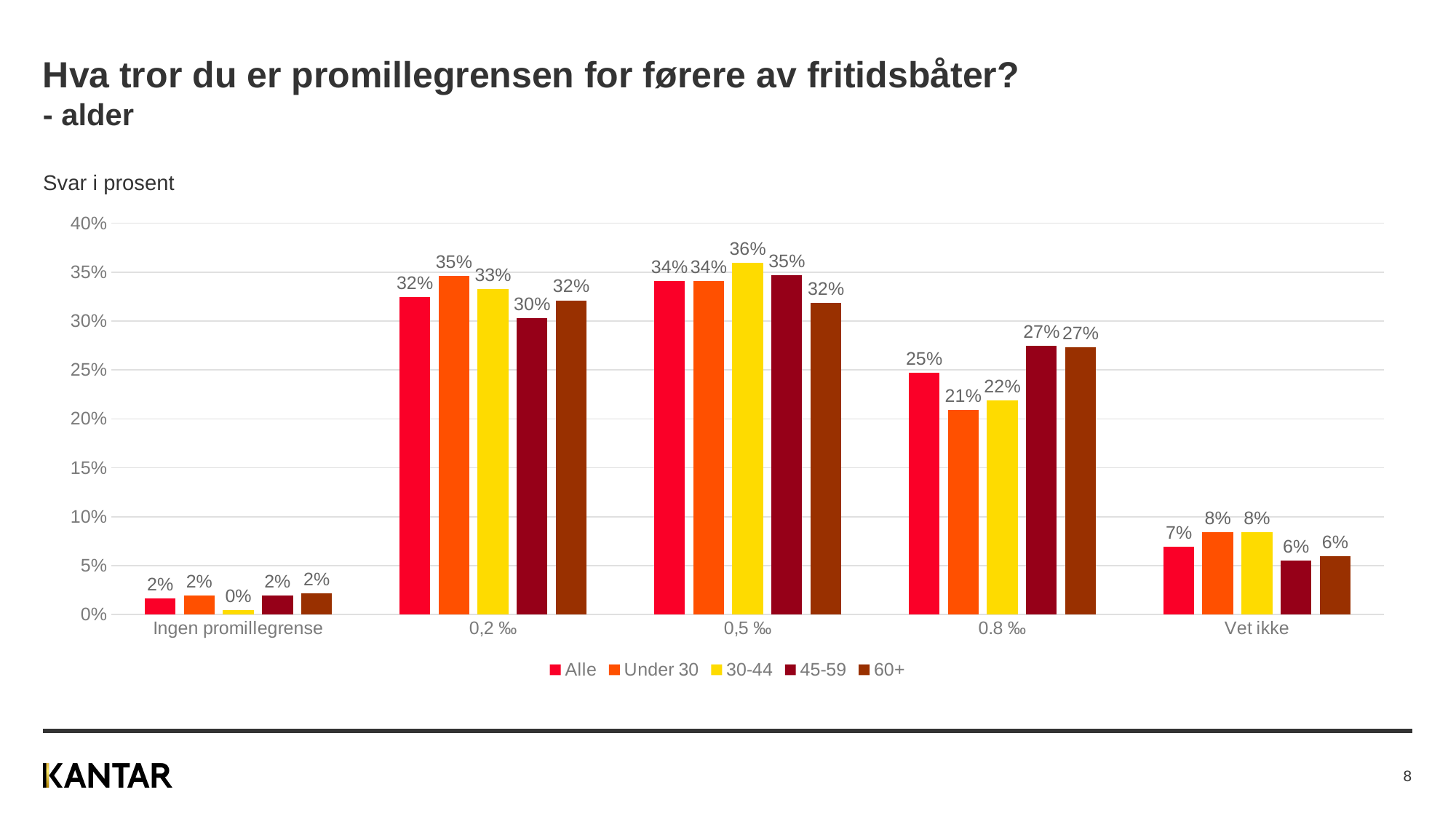
What is the value for the 30-44 series in the 0,5 ‰ category? 36% Is the value for the 60+ series in the 0,5 ‰ category greater or less than 30%? greater What is the value for the Under 30 series in the 0.8 ‰ category? 21% What is the value for the 45-59 series in the 0,2 ‰ category? 30% Which series has the lowest value in the 0.8 ‰ category? Under 30 How many categories are shown on the x axis? 5 Which is larger in the Vet ikke category: the Alle value or the 45-59 value? Alle What kind of chart is shown on the slide? Bar chart How many series does the legend list? 5 Which series has the highest value in the 0,2 ‰ category? Under 30 What is the difference between the 45-59 and Under 30 values in the 0.8 ‰ category? 6% What is the value for the 30-44 series in the Ingen promillegrense category? 0%